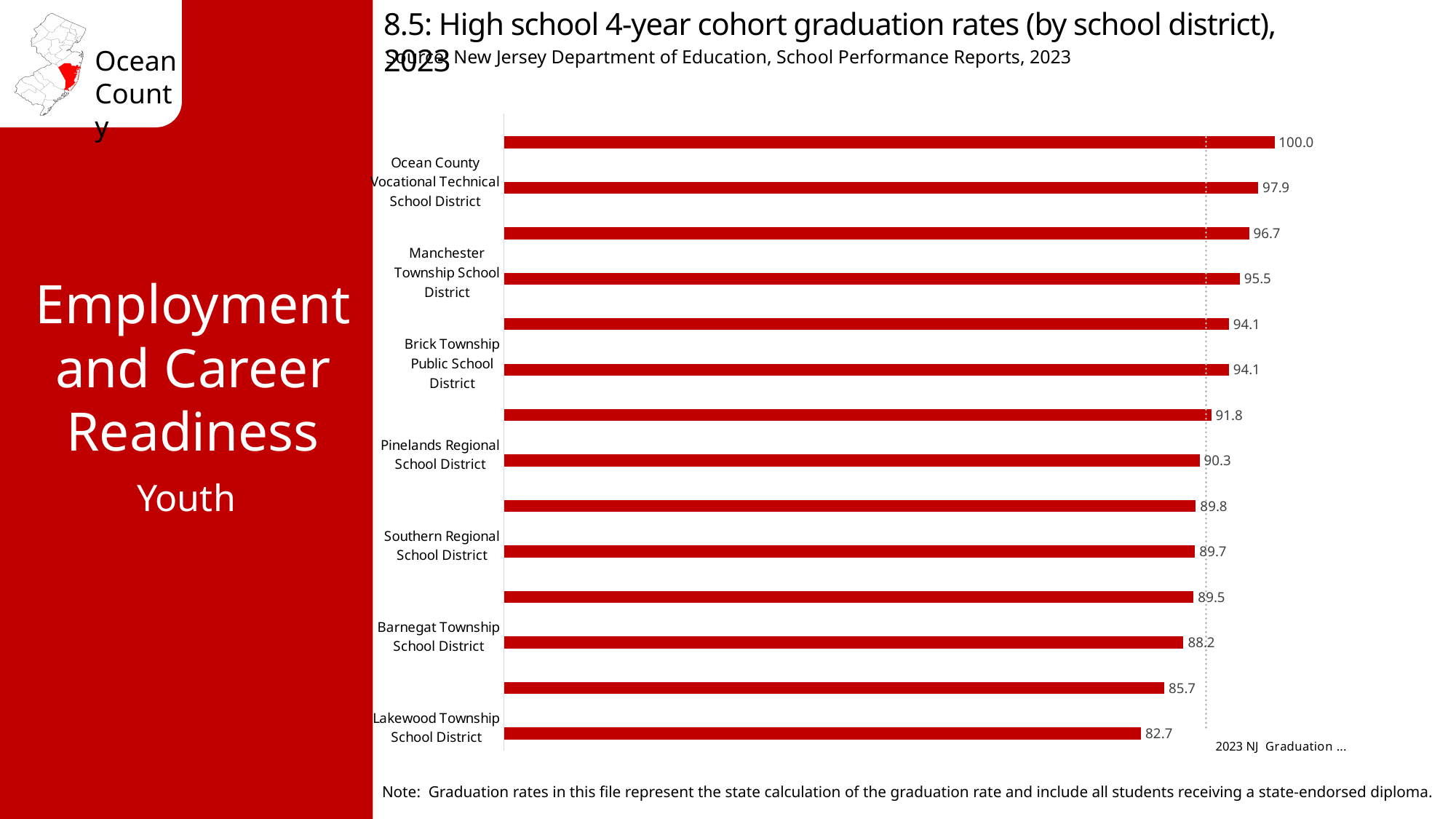
What is the source cited for the chart data? New Jersey Department of Education, School Performance Reports, 2023 What is the difference between the graduation rates of Manchester Township School District and Lakewood Township School District? 12.8 How many bars are plotted in the chart? 14 What is the graduation rate for Pinelands Regional School District? 90.3 What is the graduation rate for Lakewood Township School District? 82.7 What is the graduation rate for Manchester Township School District? 95.5 Which labelled school district has the lowest graduation rate? Lakewood Township School District What is the lowest graduation rate shown in the chart? 82.7 What is the highest graduation rate shown in the chart? 100.0 What kind of chart is shown on the slide? bar chart Which has a higher graduation rate, Brick Township Public School District or Pinelands Regional School District? Brick Township Public School District What is the graduation rate for Barnegat Township School District? 88.2